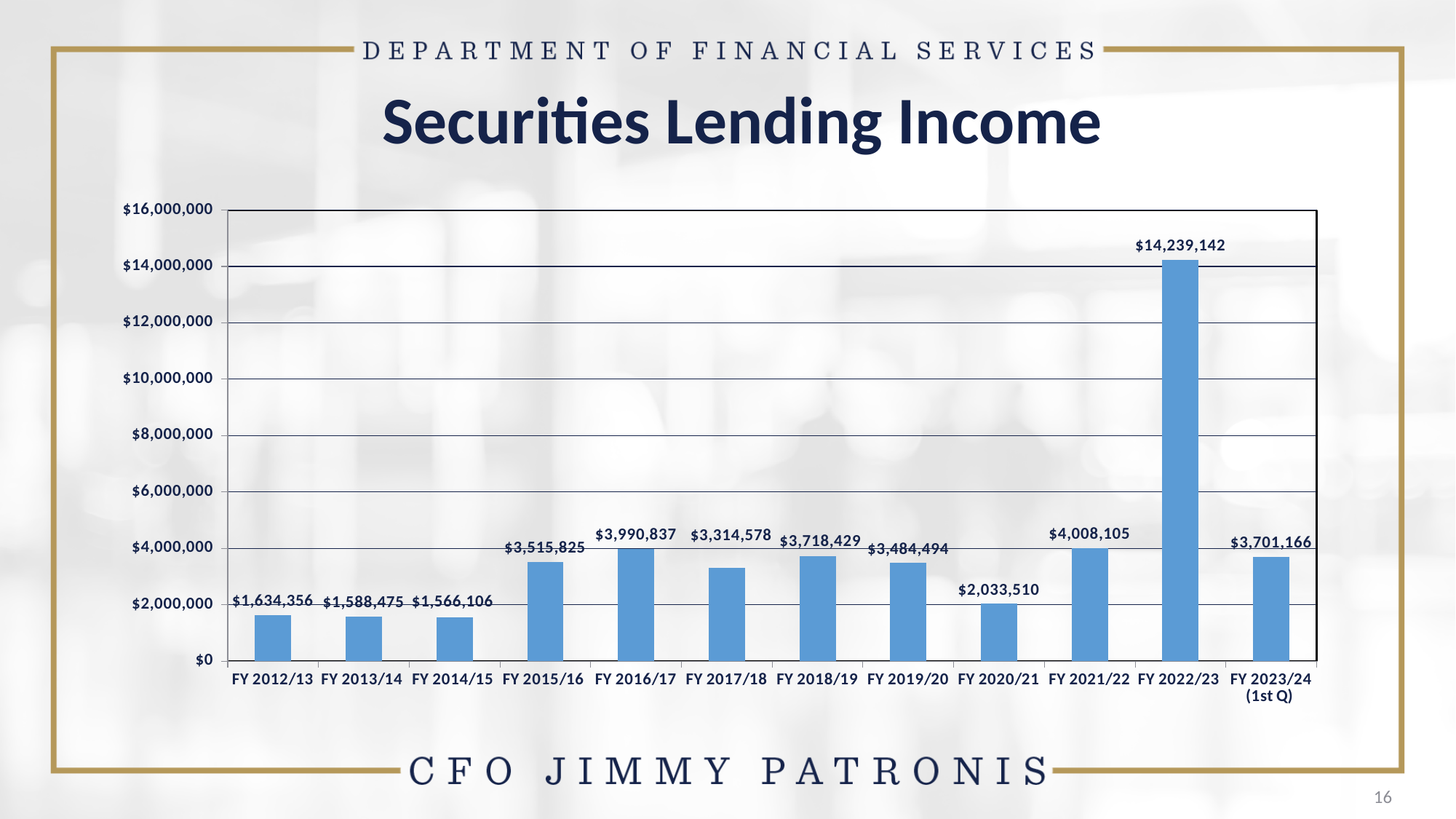
Is the value for FY 2022/23 greater or less than $14,000,000? greater What is the value shown for FY 2023/24 (1st Q)? $3,701,166 What is the securities lending income for FY 2012/13? $1,634,356 How much greater is the income for FY 2022/23 than for FY 2021/22? $10,231,037 How many fiscal years are shown on the chart? 12 What is the securities lending income for FY 2020/21? $2,033,510 What is the securities lending income for FY 2022/23? $14,239,142 Which fiscal year has the highest securities lending income? FY 2022/23 What is the difference between the income for FY 2016/17 and FY 2015/16? $475,012 Which fiscal year has the lowest securities lending income? FY 2014/15 Which is larger, the income for FY 2021/22 or FY 2017/18? FY 2021/22 What kind of chart is shown on the slide? Bar chart